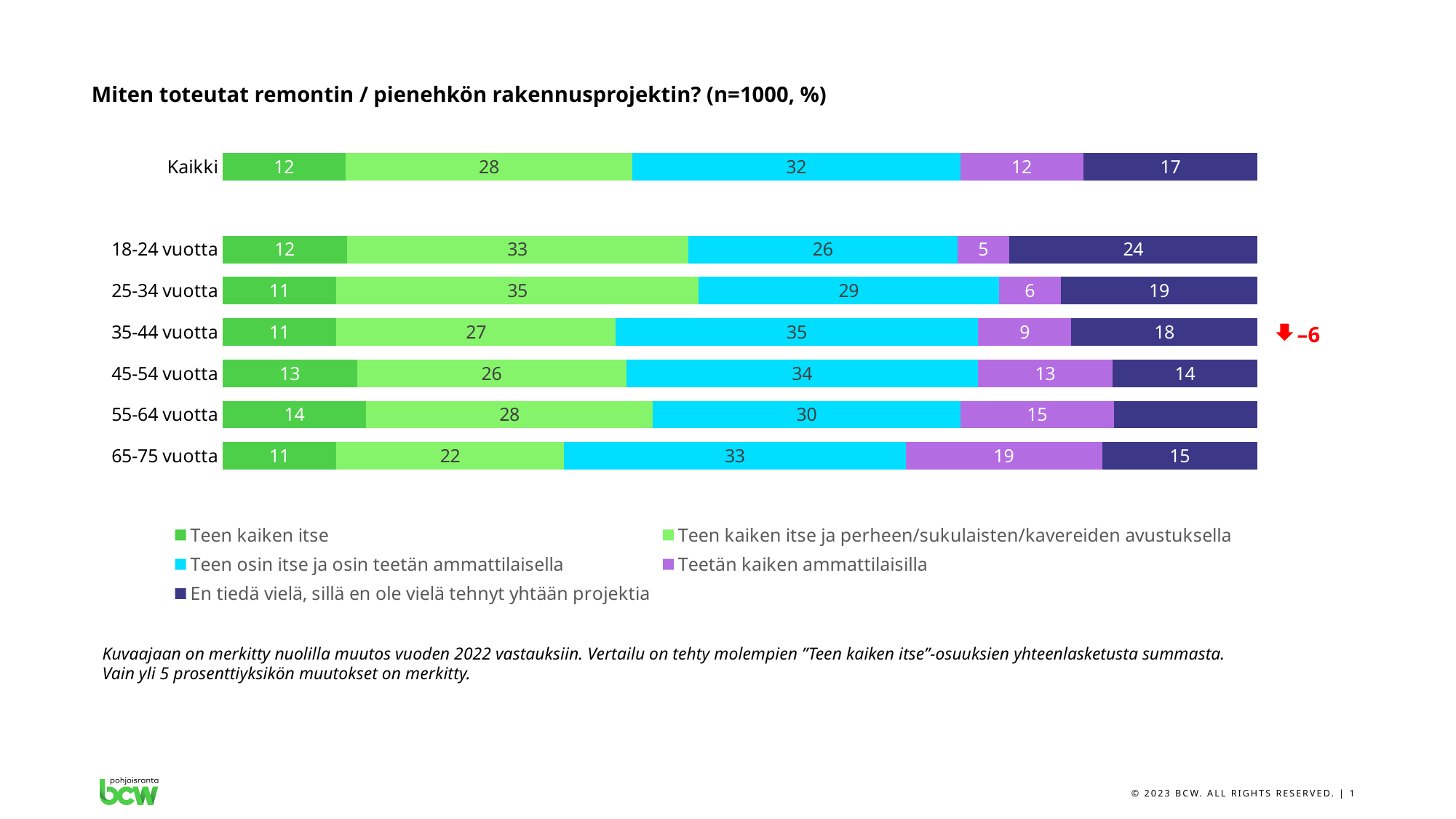
What is the difference between the 'Teetän kaiken ammattilaisilla' values for 65-75 vuotta and 18-24 vuotta? 14 What is the total of the stacked bar for 18-24 vuotta? 100 What is the value of 'En tiedä vielä, sillä en ole vielä tehnyt yhtään projektia' for 18-24 vuotta? 24 How many series does the legend list? 5 Which age group has the lowest value for 'Teetän kaiken ammattilaisilla'? 18-24 vuotta Which age group is marked with a red arrow showing a change of -6? 35-44 vuotta How many age groups (excluding Kaikki) are shown on the chart? 6 What kind of chart is shown on the slide? Stacked bar chart What is the value of 'Teetän kaiken ammattilaisilla' for 65-75 vuotta? 19 Which age group has the highest value for 'Teetän kaiken ammattilaisilla'? 65-75 vuotta What is the value of 'Teen osin itse ja osin teetän ammattilaisella' for Kaikki? 32 Which is larger: the 'Teen kaiken itse ja perheen/sukulaisten/kavereiden avustuksella' value for 25-34 vuotta or for 65-75 vuotta? 25-34 vuotta